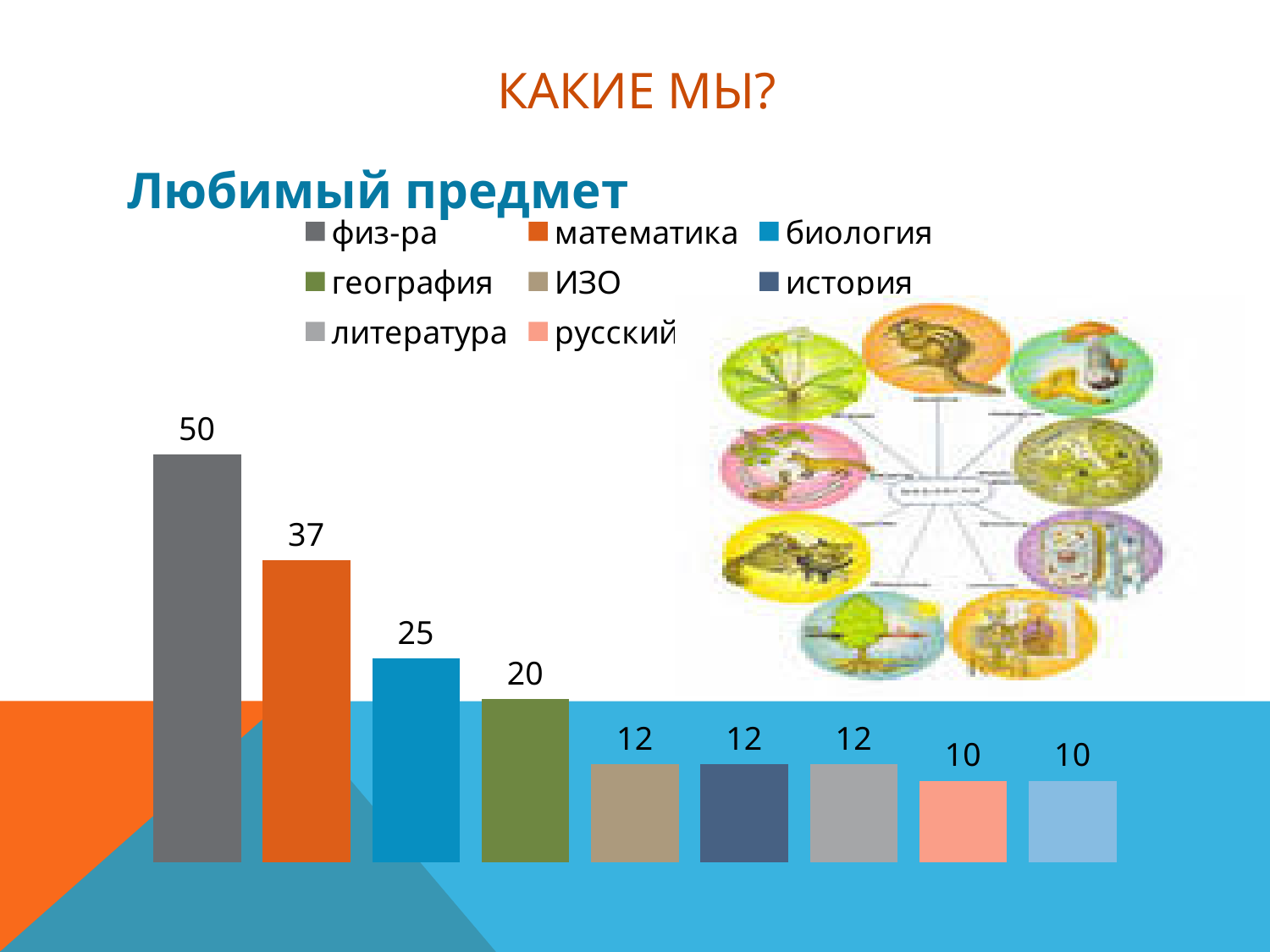
What is the value for биология in the Любимый предмет chart? 25 What is the value for физ-ра in the Любимый предмет chart? 50 How many bars are plotted in the Любимый предмет chart? 9 What is the difference between the values for физ-ра and математика in the Любимый предмет chart? 13 Do the bar values rise or fall from left to right in the Любимый предмет chart? fall Which has a larger value in the Любимый предмет chart, биология or география? биология What is the value for география in the Любимый предмет chart? 20 Which subject has the highest value in the Любимый предмет chart? физ-ра What kind of chart is the Любимый предмет chart? bar chart What is the title of the chart on the slide? Любимый предмет What is the value for математика in the Любимый предмет chart? 37 What is the value for русский in the Любимый предмет chart? 10